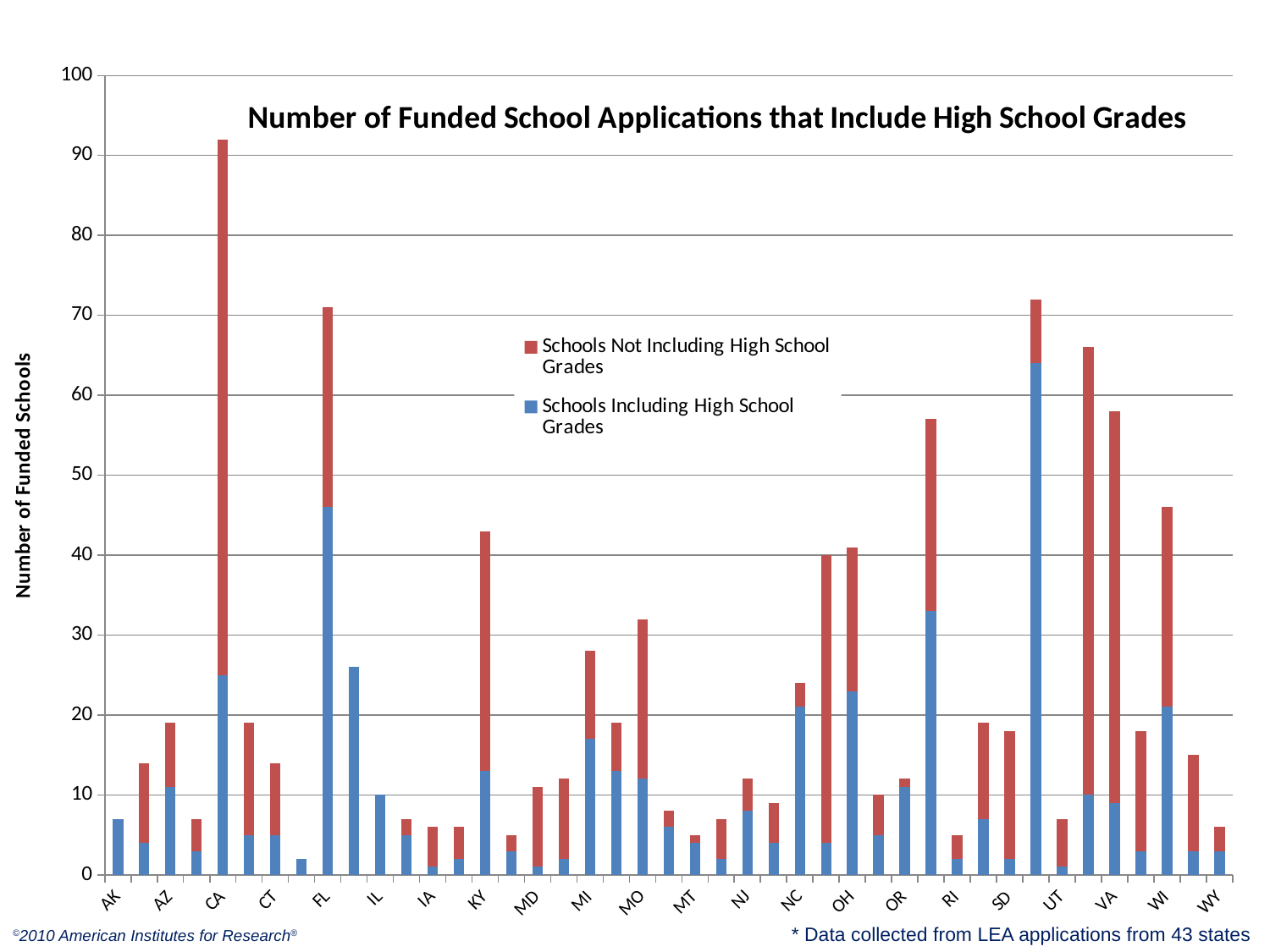
Which colour represents 'Schools Including High School Grades' in the legend? Blue Is the total value for KY greater or less than 40? greater Is the total value for IL greater or less than 20? less Which state has the highest total number of funded schools? CA Is the 'Schools Including High School Grades' value for FL greater or less than 40? greater Which has a larger total, CA or FL? CA How many series does the legend list? 2 What kind of chart is shown on the slide? Stacked bar chart Which has a larger total, MI or MO? MO